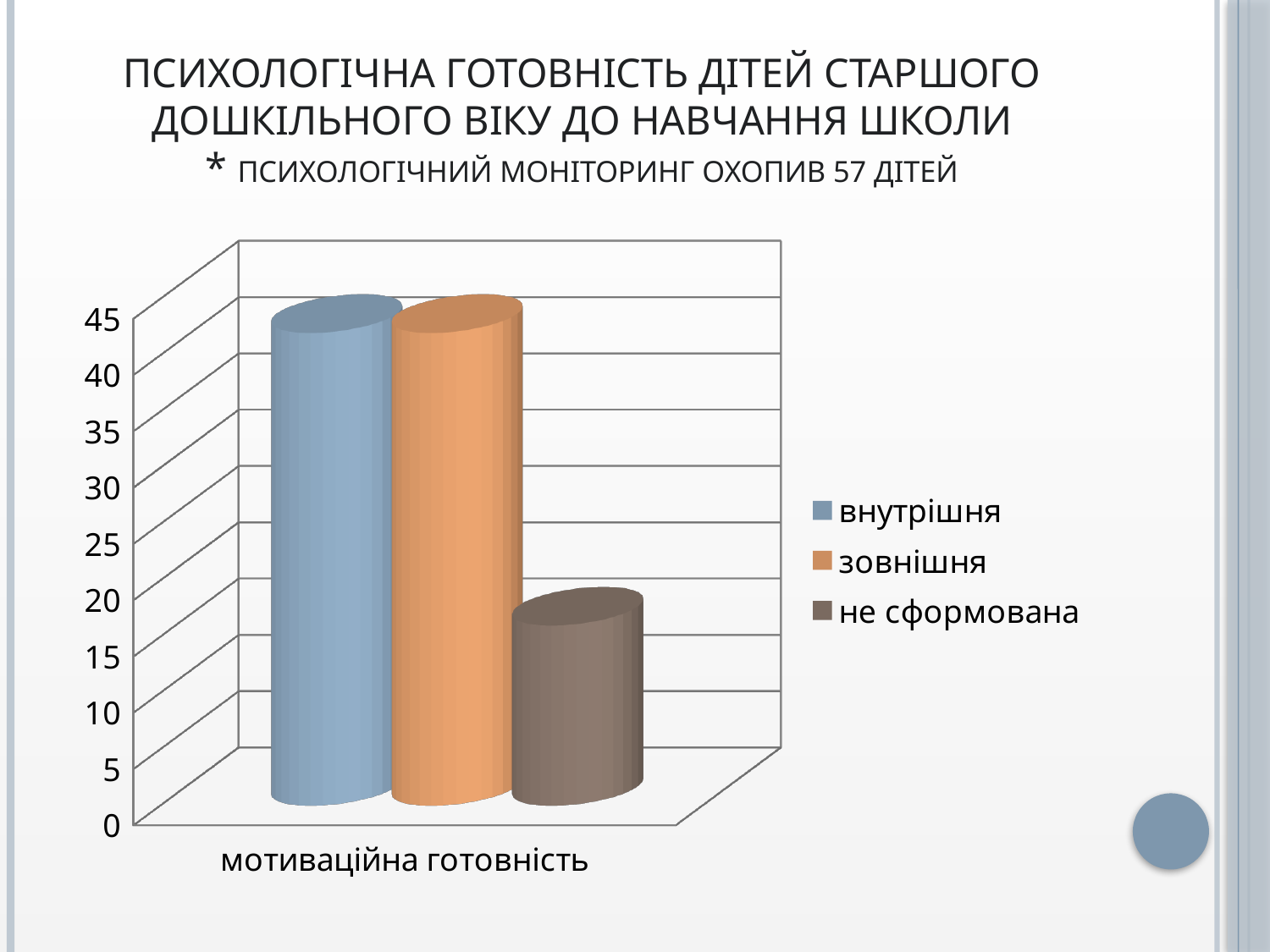
Which is larger for мотиваційна готовність: зовнішня or не сформована? зовнішня Which series has the lowest value for мотиваційна готовність? не сформована Which series is shown in orange in the legend? зовнішня Is the value for зовнішня greater or less than 30? greater Which is larger for мотиваційна готовність: внутрішня or не сформована? внутрішня What kind of chart is shown on the slide? bar chart How many categories are shown on the x axis? 1 Is the value for внутрішня greater or less than 30? greater What is the category label shown on the x axis? мотиваційна готовність Is the value for не сформована greater or less than 25? less How many series does the legend list? 3